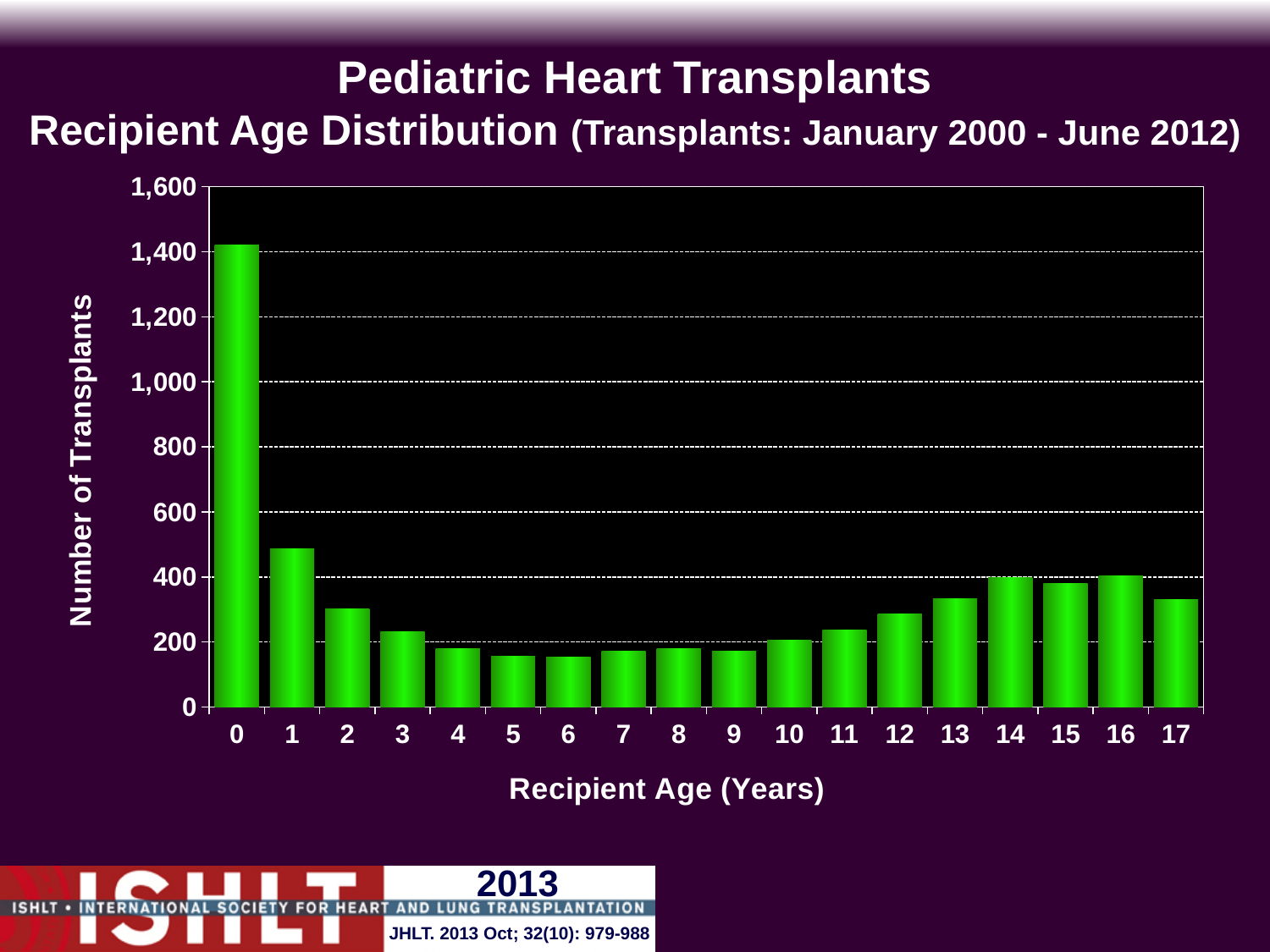
Is the number of transplants for recipient age 0 greater or less than 1,200? greater Is the number of transplants for recipient age 13 greater or less than 200? greater What is the label of the y axis? Number of Transplants Do the number of transplants generally rise or fall from recipient age 0 to recipient age 5? fall Which recipient age has the highest number of transplants? 0 Which has more transplants, recipient age 1 or recipient age 2? 1 Is the number of transplants for recipient age 1 greater or less than 600? less How many recipient age categories are shown on the x axis? 18 Which has more transplants, recipient age 12 or recipient age 14? 14 What kind of chart is shown on the slide? bar chart